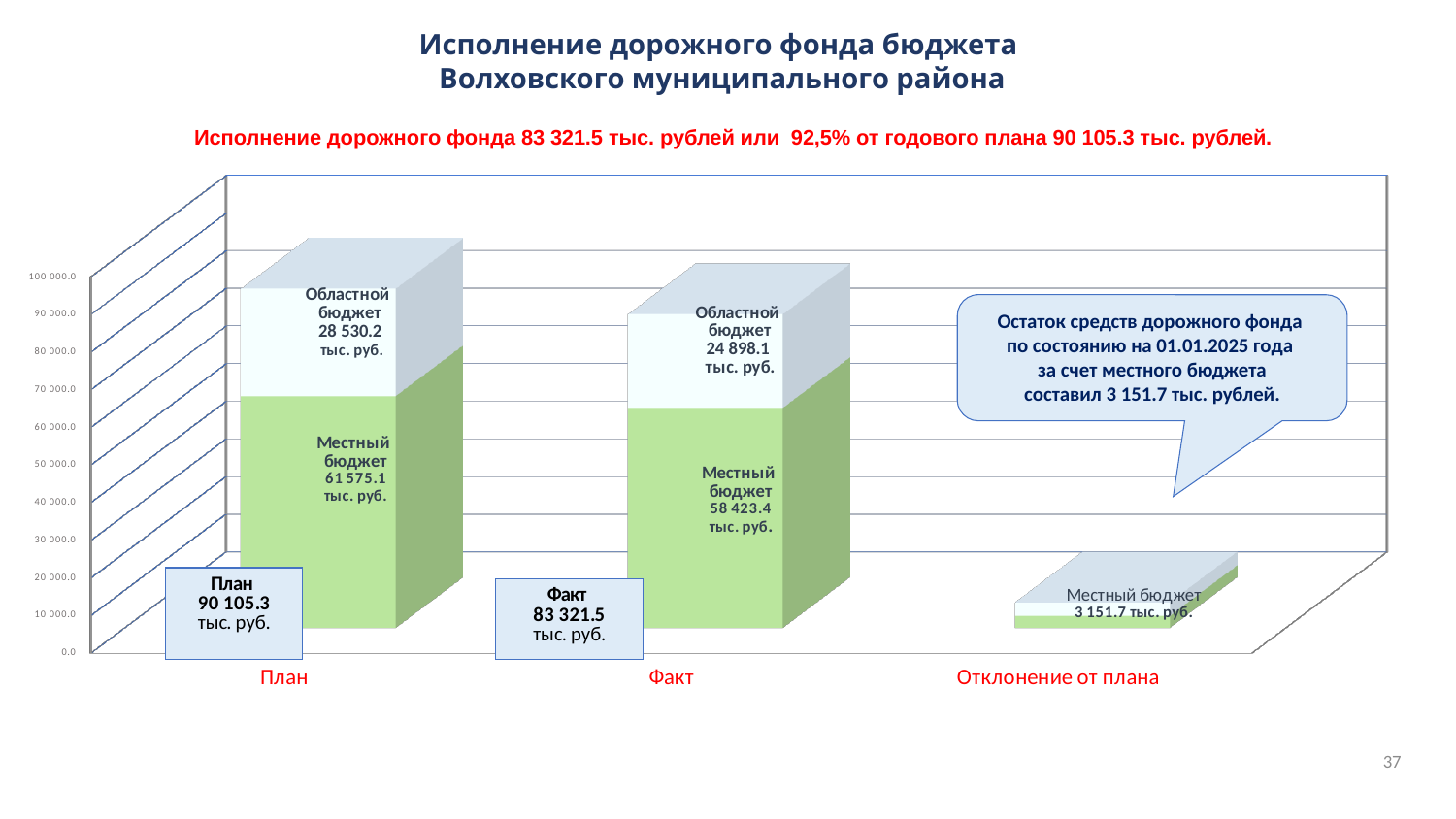
Which category has the highest total bar? План Which category has the lowest total bar? Отклонение от плана What is the value of the Местный бюджет segment for the План category? 61 575.1 тыс. руб. What is the total of the stacked bar for План? 90 105.3 тыс. руб. What is the value of the Областной бюджет segment for the Факт category? 24 898.1 тыс. руб. What is the difference between the Местный бюджет values for План and Факт? 3 151.7 тыс. руб. What is the total of the stacked bar for Факт? 83 321.5 тыс. руб. Which is larger: the Местный бюджет segment for План or for Факт? План What is the value shown for Местный бюджет in the Отклонение от плана category? 3 151.7 тыс. руб. What kind of chart is shown on the slide? Stacked bar chart How many categories are shown on the x axis? 3 What is the difference between the Областной бюджет values for План and Факт? 3 632.1 тыс. руб.